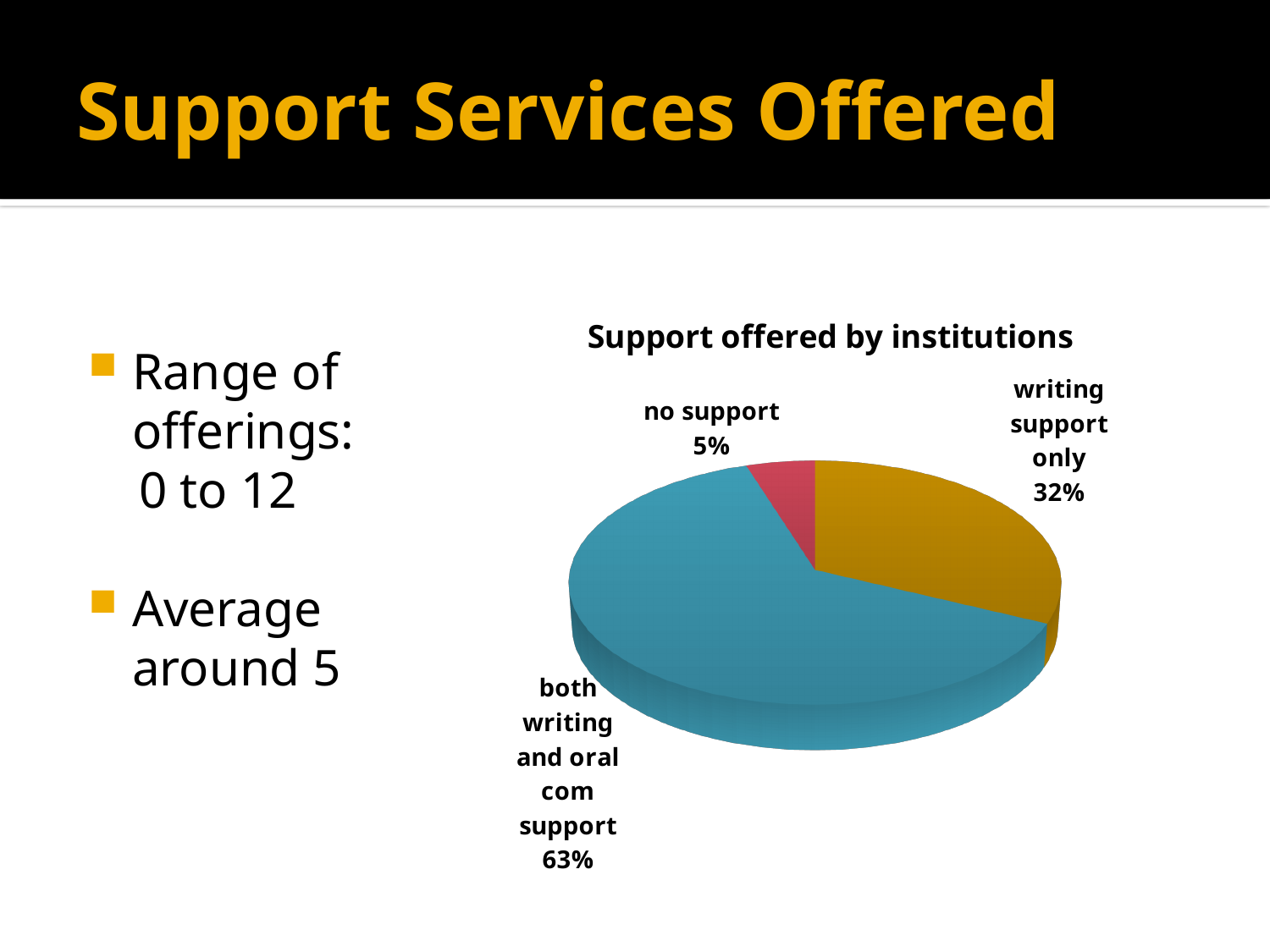
How many slices does the pie chart have? 3 What kind of chart is shown on the slide? pie chart Which category has the largest slice of the pie? both writing and oral com support Which category has the smallest slice of the pie? no support What share of institutions offer no support? 5% What is the difference in percentage points between 'writing support only' and 'no support'? 27 Which is larger: the share for 'writing support only' or the share for 'no support'? writing support only What is the difference in percentage points between 'both writing and oral com support' and 'writing support only'? 31 What share of institutions offer writing support only? 32% What is the title of the chart? Support offered by institutions What colour is the slice for 'no support'? red What share of institutions offer both writing and oral com support? 63%